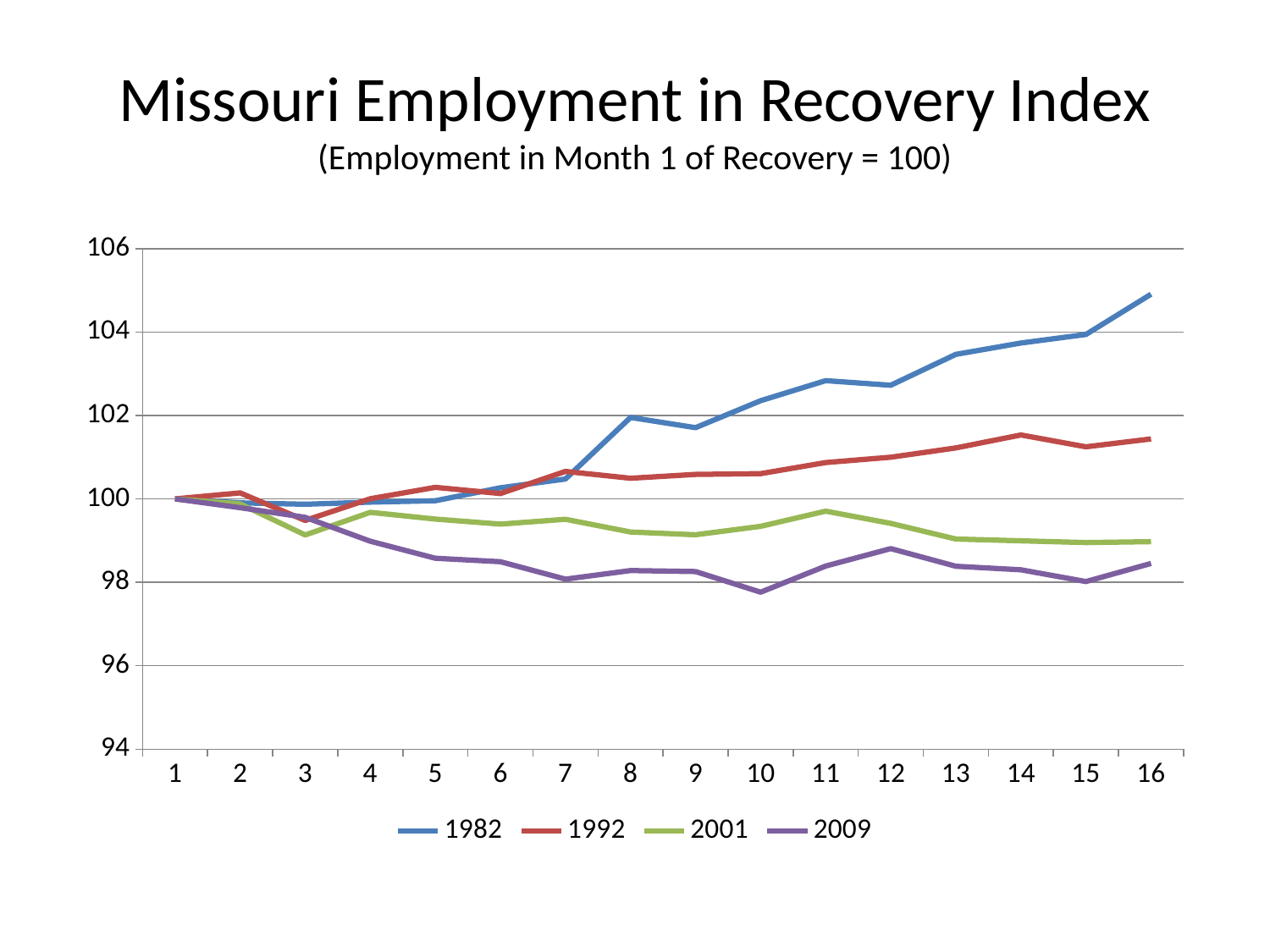
Is the value for the 2001 series in month 13 greater or less than 100? less Is the value for the 2009 series in month 10 greater or less than 98? less Which series has the highest value in month 16? 1982 What is the index value for every series in month 1? 100 Which series has the lowest value in month 16? 2009 How many months are shown along the x axis? 16 How many series does the legend list? 4 What is the title of the chart? Missouri Employment in Recovery Index Is the value for the 1982 series in month 16 greater or less than 104? greater In month 12, which series has the larger value, 1992 or 2001? 1992 What type of chart is shown on the slide? line chart Does the 1982 series generally rise or fall from month 1 to month 16? rise